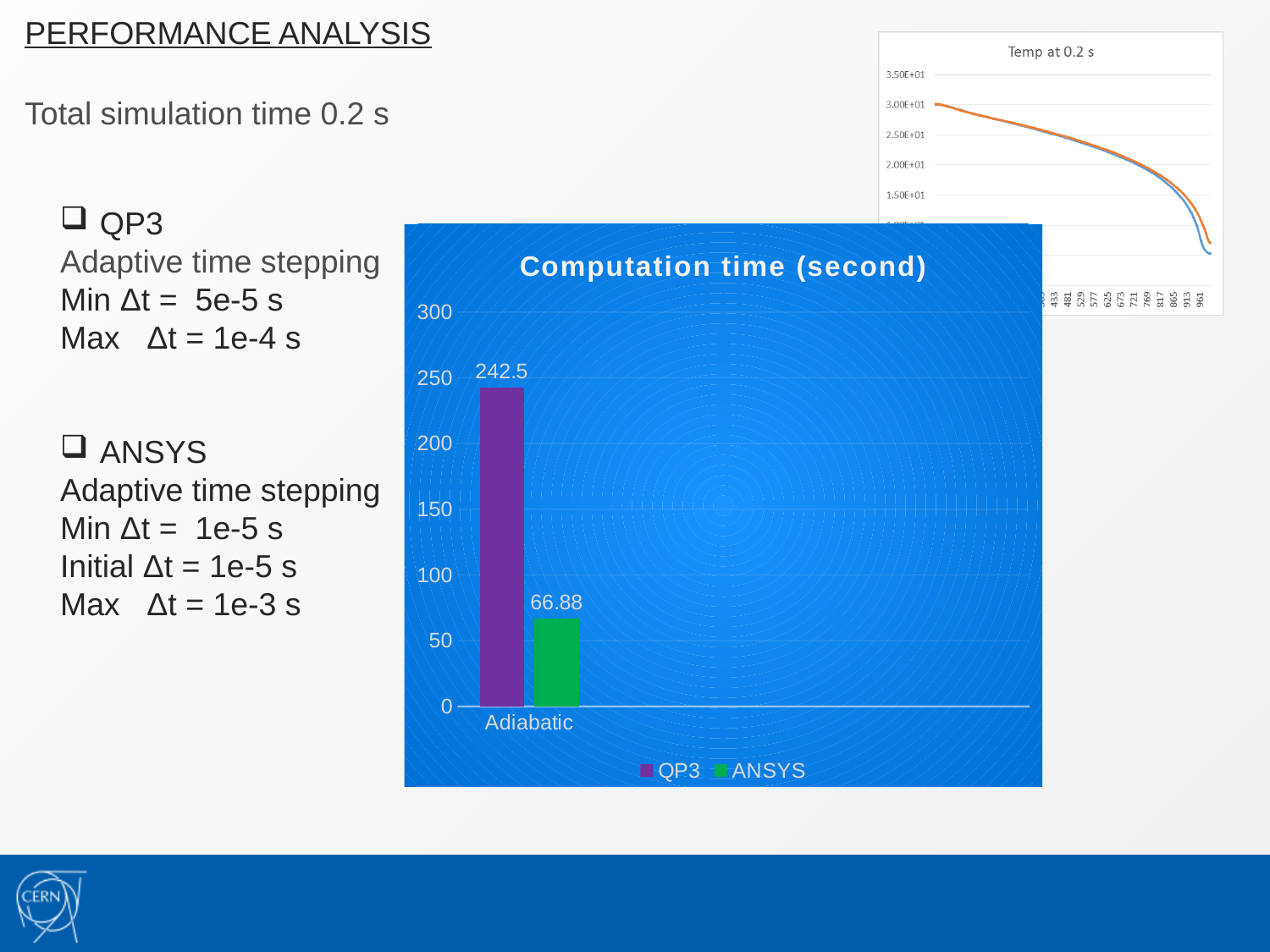
In the 'Computation time (second)' chart, which series has the higher computation time? QP3 In the 'Computation time (second)' chart, what is the value for QP3? 242.5 In the 'Computation time (second)' chart, which series has the lower computation time? ANSYS In the 'Computation time (second)' chart, what is the difference between the QP3 and ANSYS values? 175.62 How many categories are shown on the x axis of the 'Computation time (second)' chart? 1 In the 'Computation time (second)' chart, what is the value for ANSYS? 66.88 What kind of chart is the 'Computation time (second)' chart? Bar chart In the 'Computation time (second)' chart, is the value for QP3 greater or less than 200? greater In the 'Computation time (second)' chart, is the value for ANSYS greater or less than 100? less In the 'Temp at 0.2 s' chart in the top right, do the plotted values rise or fall along the x axis? Fall How many series does the legend of the 'Computation time (second)' chart list? 2 What is the name of the category on the x axis of the 'Computation time (second)' chart? Adiabatic